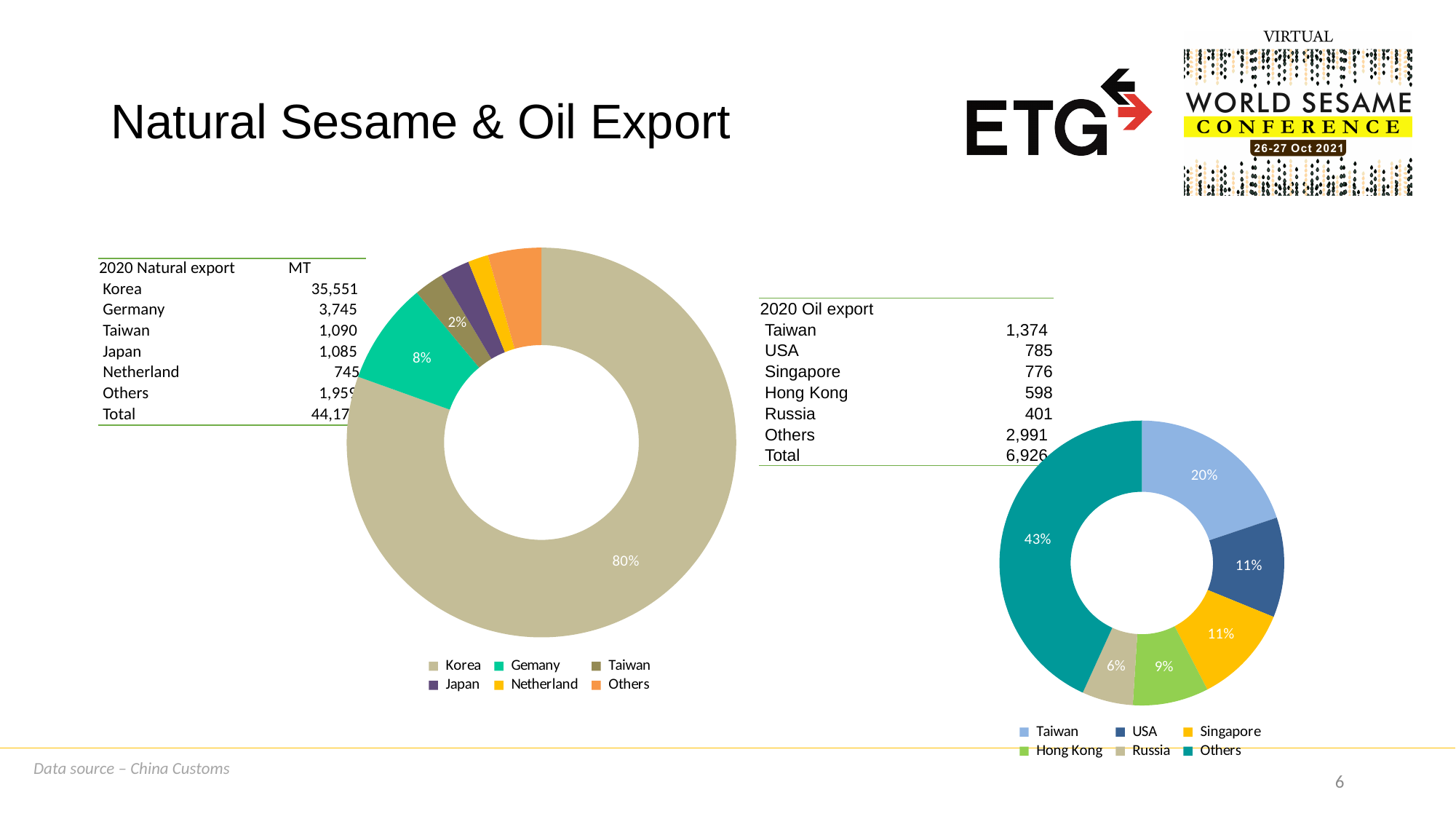
In the left chart (2020 Natural export), what percentage is shown for Germany? 8% How many entries does the legend of the left chart (2020 Natural export) list? 6 In the right chart (2020 Oil export), what colour is the Others slice? Teal In the right chart (2020 Oil export), what share does Taiwan hold? 20% In the right chart (2020 Oil export), what percentage is shown for Others? 43% In the left chart (2020 Natural export), which category has the largest slice? Korea In the right chart (2020 Oil export), what is the difference between the Taiwan share and the Hong Kong share? 11% How many categories does the legend of the right chart (2020 Oil export) list? 6 In the right chart (2020 Oil export), which is larger, the Hong Kong slice or the Russia slice? Hong Kong In the right chart (2020 Oil export), which category has the smallest slice? Russia In the left chart (2020 Natural export), what share of the pie does Korea hold? 80% What kind of chart is the left chart on the slide (2020 Natural export)? Donut (pie) chart